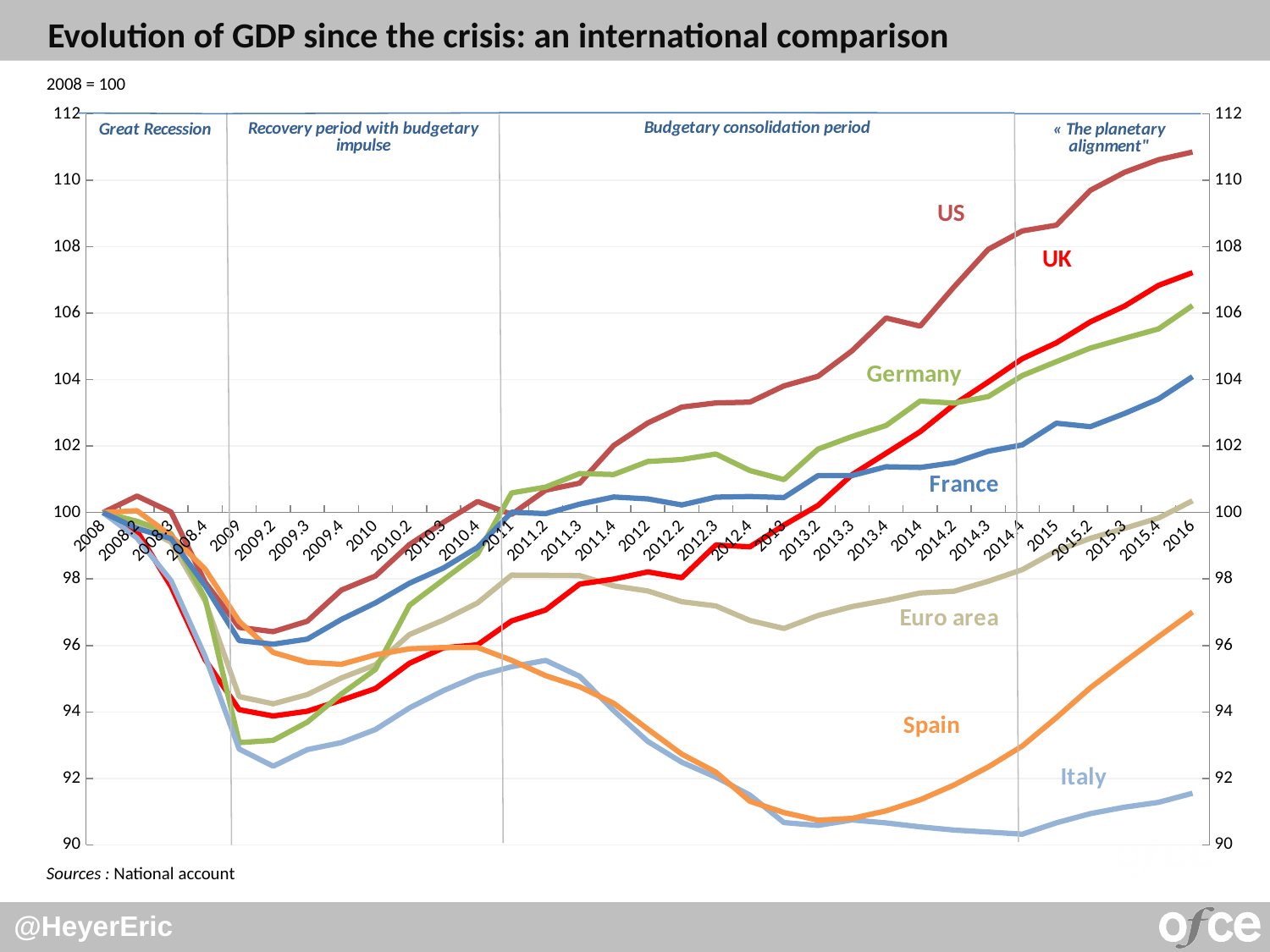
Which series has the highest value at 2016? US Is the value for Spain at 2013.2 greater or less than 92? less Is the value for the US at 2016 greater or less than 110? greater What is the title of the chart? Evolution of GDP since the crisis: an international comparison Does the US series rise or fall between 2011 and 2016? rise At 2016, which is larger, the value for Spain or the value for Italy? Spain What kind of chart is shown on the slide? line chart Is the value for Italy at 2016 greater or less than 92? less Which series has the lowest value at 2016? Italy At 2016, which is larger, the value for the US or the value for the UK? US How many countries or regions are plotted as series on the chart? 7